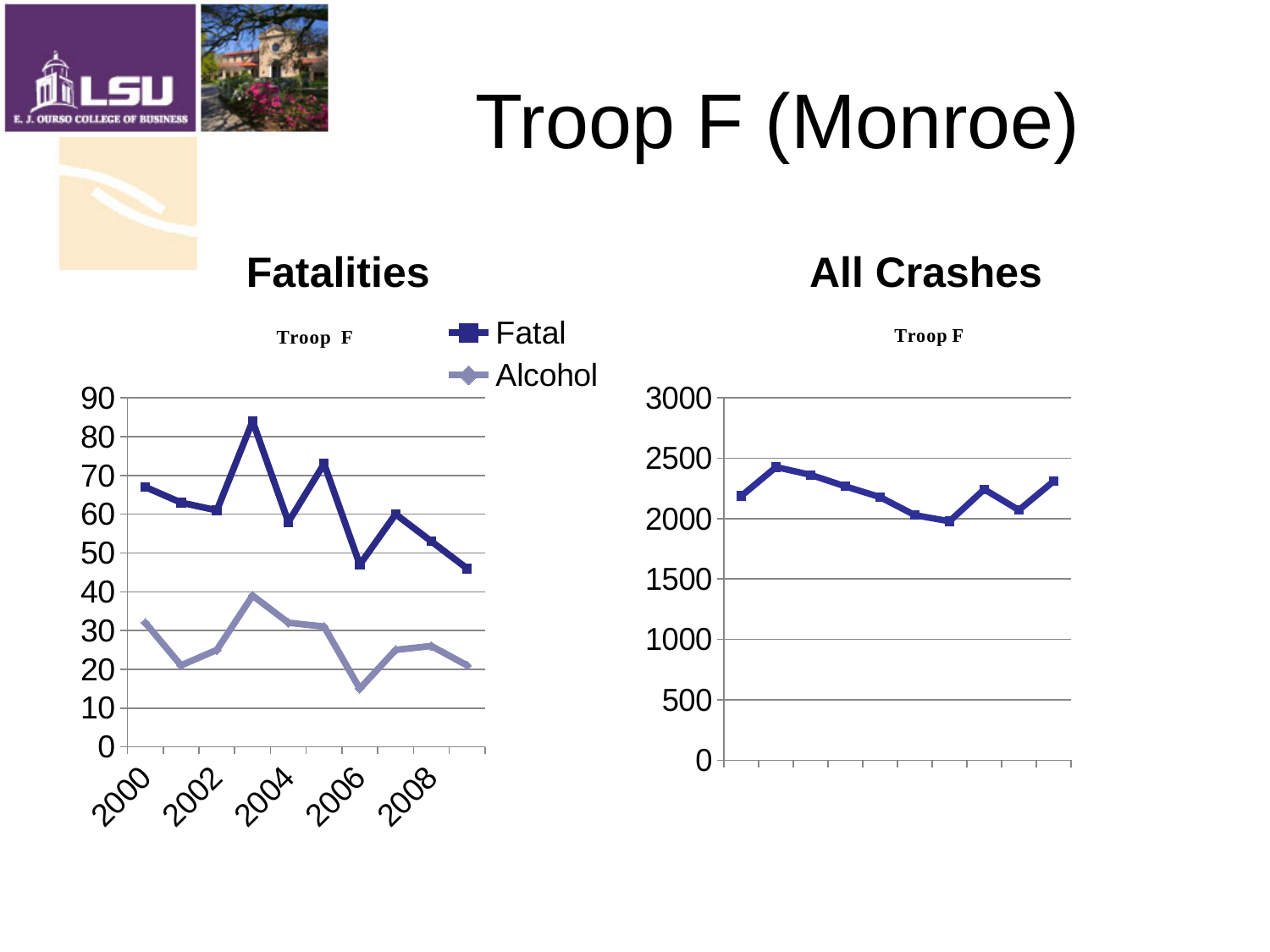
On the Fatalities chart, which year has the highest value for the Alcohol series? 2003 On the Fatalities chart, does the Fatal series overall rise or fall from 2000 to 2009? fall On the All Crashes chart, is the highest point greater or less than 2000? greater On the Fatalities chart, which year has the lowest value for the Fatal series? 2009 On the Fatalities chart, which year has the lowest value for the Alcohol series? 2006 On the Fatalities chart, which is larger in 2005, the Fatal value or the Alcohol value? Fatal On the Fatalities chart, is the Alcohol value for 2006 greater or less than 20? less On the Fatalities chart, is the Fatal value for 2000 greater or less than 60? greater What kind of chart is the All Crashes chart? line chart On the Fatalities chart, which year has the highest value for the Fatal series? 2003 How many series does the legend of the Fatalities chart list? 2